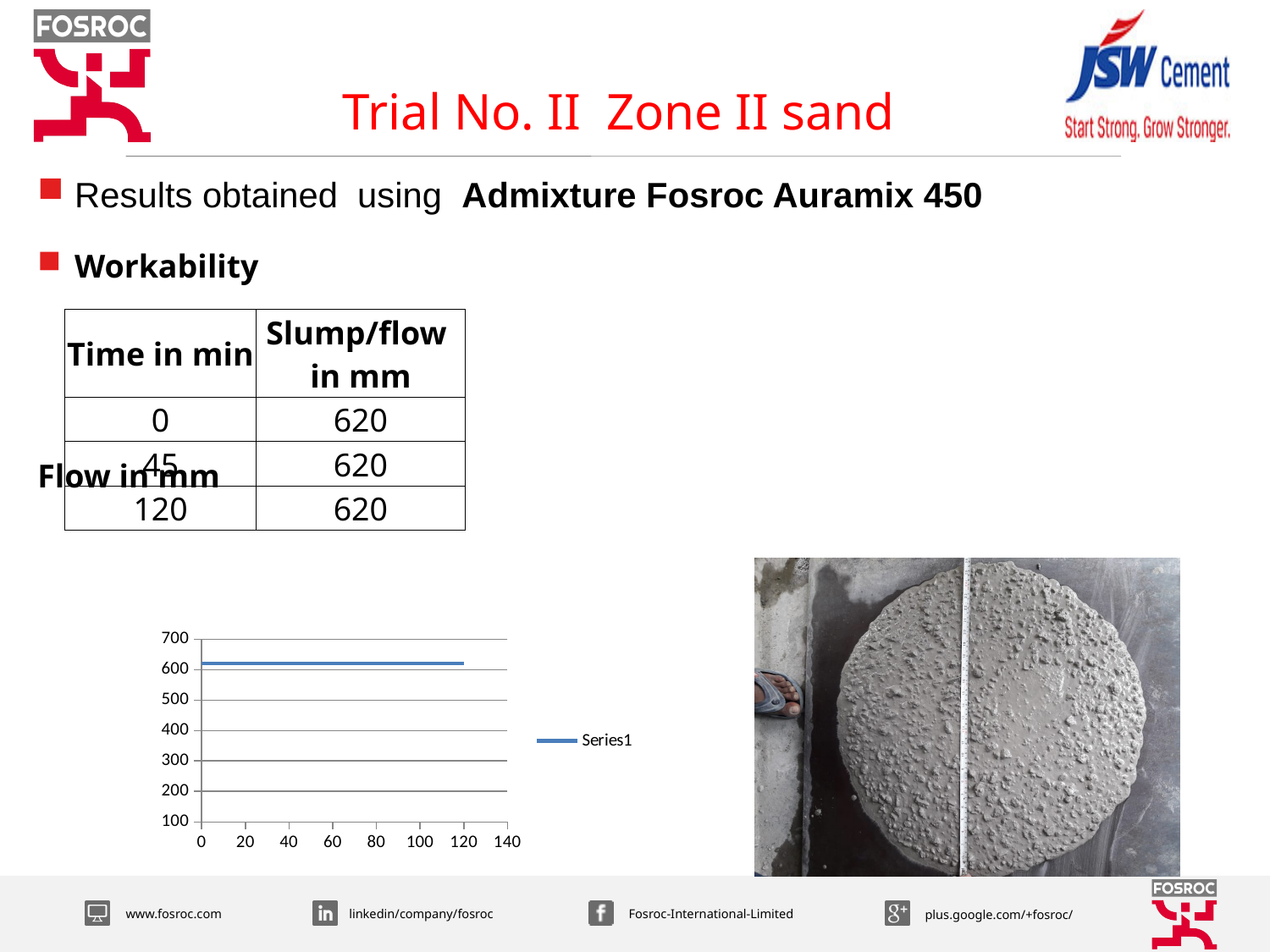
How many series does the chart's legend list? 1 What is the name of the series shown in the chart's legend? Series1 Is the value of Series1 at x = 0 greater or less than 500? greater Does the plotted line rise, fall, or stay flat as the x-axis value increases from 0 to 120? stays flat What kind of chart is shown on the slide? line chart Is the value of Series1 at x = 60 greater or less than 400? greater What is the highest tick value shown on the chart's vertical axis? 700 Is the value of Series1 at x = 120 greater or less than 700? less